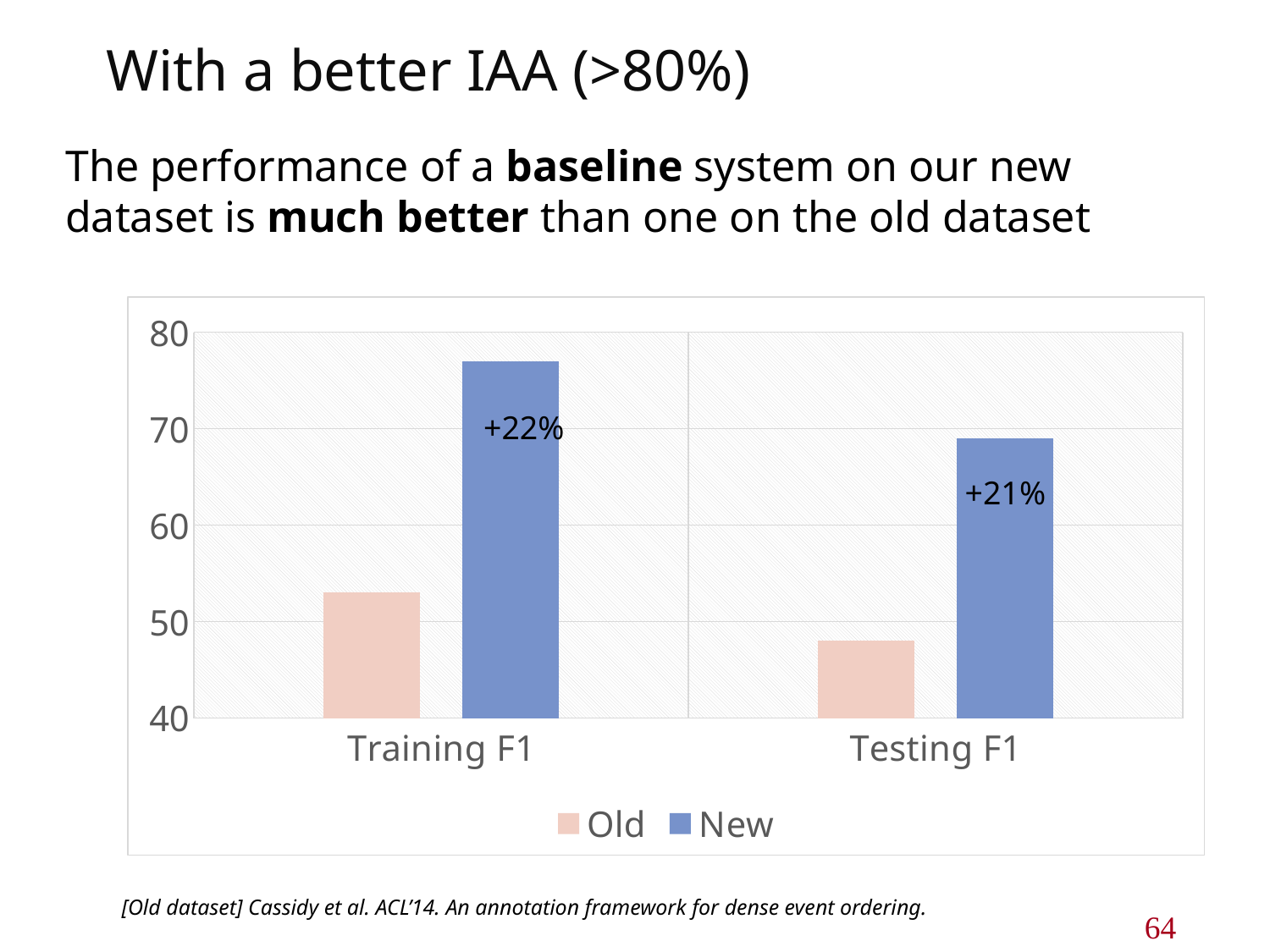
Which series has the higher Testing F1 value, Old or New? New What improvement label is printed on the New bar for Testing F1? +21% Is the Old Training F1 value greater or less than 60? less How many series does the chart legend list? 2 Which series has the higher Training F1 value, Old or New? New Is the New Testing F1 value greater or less than 60? greater Which bar in the chart is the tallest? New, Training F1 How many categories are shown on the x axis of the chart? 2 Which bar in the chart is the shortest? Old, Testing F1 What kind of chart is shown on the slide? bar chart Is the Old Testing F1 value greater or less than 50? less